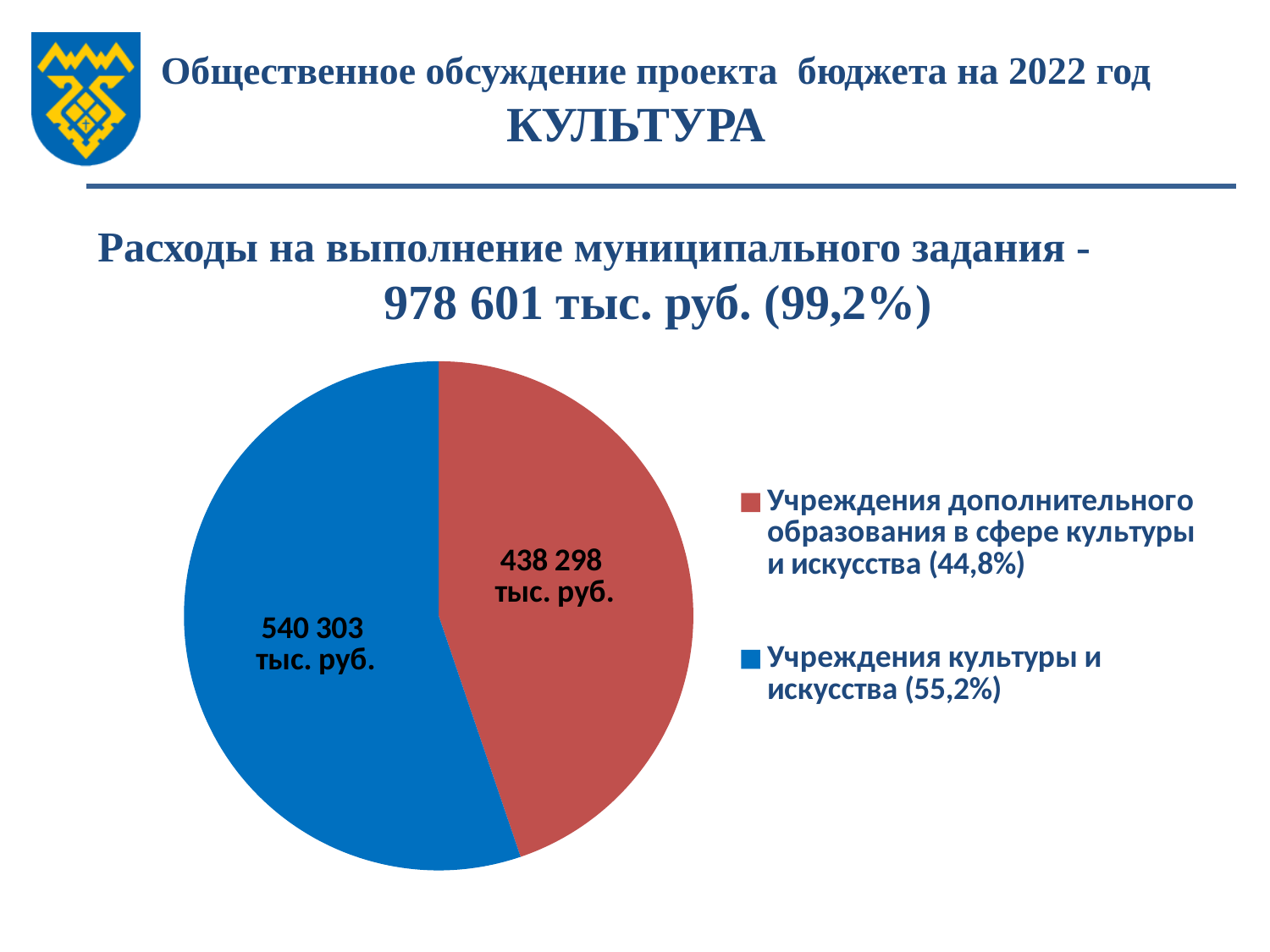
Which category has the largest slice of the pie? Учреждения культуры и искусства What is the value shown for Учреждения дополнительного образования в сфере культуры и искусства? 438 298 тыс. руб. Which is larger: the value for Учреждения культуры и искусства or the value for Учреждения дополнительного образования в сфере культуры и искусства? Учреждения культуры и искусства What is the value shown for Учреждения культуры и искусства? 540 303 тыс. руб. How many slices does the pie chart have? 2 What share of the pie does Учреждения культуры и искусства represent, as shown in the legend? 55,2% What is the difference between the values for Учреждения культуры и искусства and Учреждения дополнительного образования в сфере культуры и искусства? 102 005 тыс. руб. Which category has the smallest slice of the pie? Учреждения дополнительного образования в сфере культуры и искусства What colour is the slice for Учреждения культуры и искусства? blue What is the total of the two slices in the pie chart? 978 601 тыс. руб. What type of chart is shown on the slide? pie chart What share of the pie does Учреждения дополнительного образования в сфере культуры и искусства represent, as shown in the legend? 44,8%